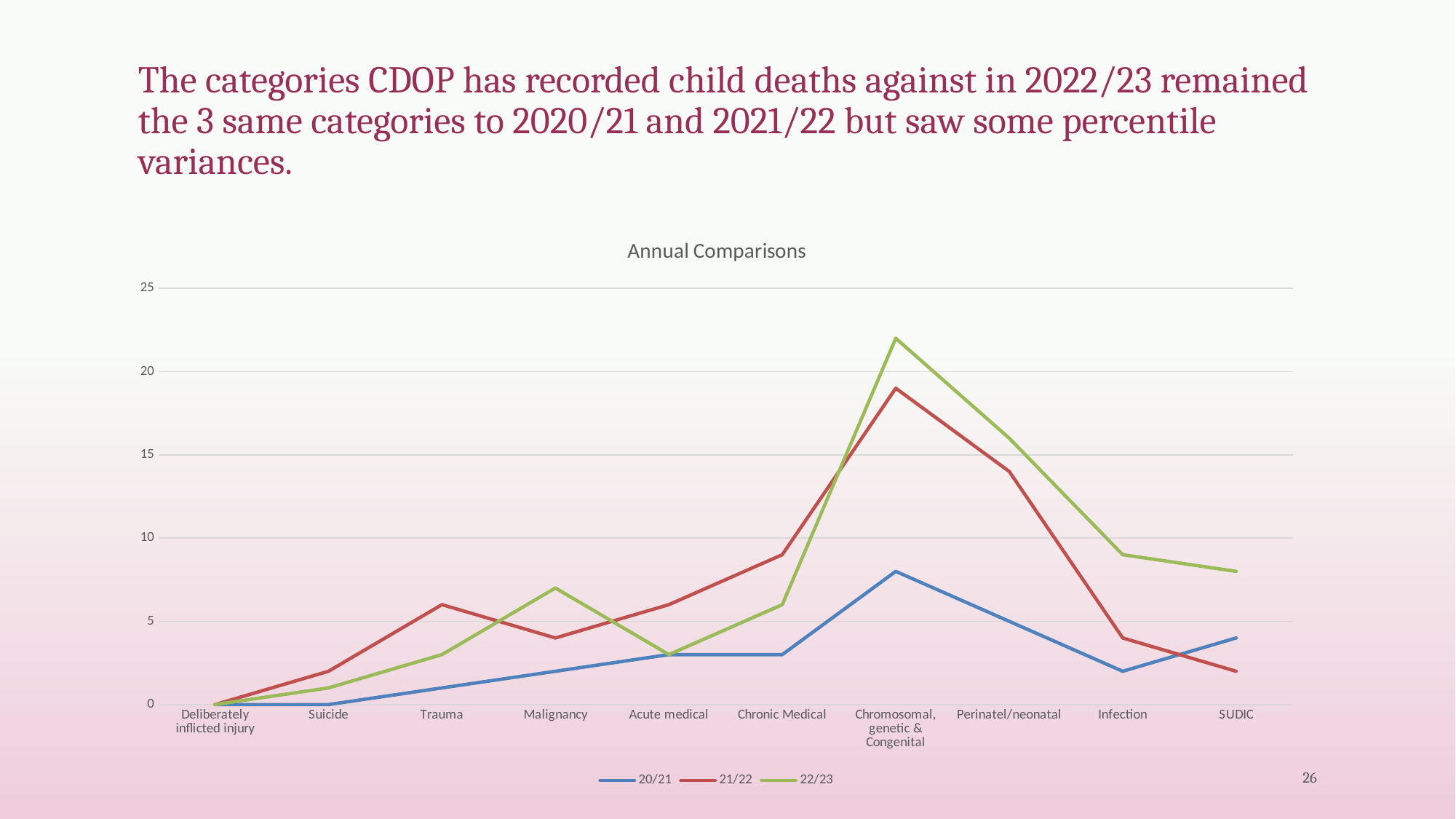
Which category has the highest value for the 22/23 series? Chromosomal, genetic & Congenital What is the value for Deliberately inflicted injury in the 21/22 series? 0 At Infection, which series has the larger value, 20/21 or 22/23? 22/23 How many categories are shown on the x axis? 10 Is the value for Chromosomal, genetic & Congenital in the 22/23 series greater or less than 20? greater What type of chart is shown on the slide? line chart What is the title of the chart? Annual Comparisons Which category has the highest value for the 20/21 series? Chromosomal, genetic & Congenital At Chromosomal, genetic & Congenital, which series has the larger value, 21/22 or 22/23? 22/23 Is the value for Infection in the 21/22 series greater or less than 5? less How many series does the legend list? 3 Does the 21/22 series rise or fall from Chromosomal, genetic & Congenital to SUDIC? fall